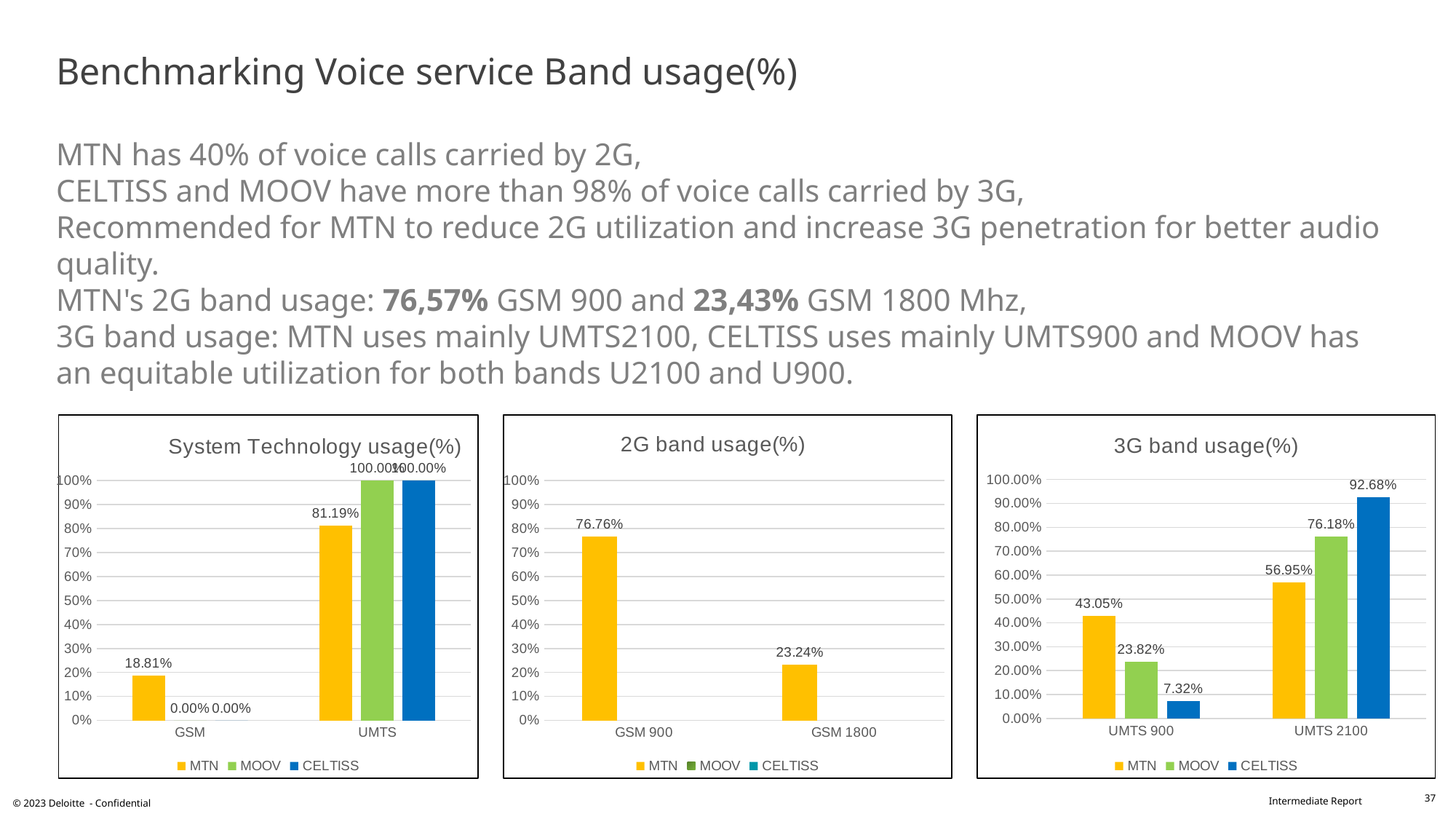
In the "System Technology usage(%)" chart, what is the value for MTN in the UMTS category? 81.19% In the "3G band usage(%)" chart, what is the value for CELTISS at UMTS 2100? 92.68% What kind of chart is the "3G band usage(%)" chart? bar chart In the "2G band usage(%)" chart, what is the difference between MTN's GSM 900 and GSM 1800 values? 53.52% In the "System Technology usage(%)" chart, what is the value for MOOV in the GSM category? 0.00% In the "3G band usage(%)" chart, is the value for MOOV at UMTS 900 larger or smaller than the value for MTN at UMTS 900? smaller In the "System Technology usage(%)" chart, what is the value for MTN in the GSM category? 18.81% In the "3G band usage(%)" chart, which series has the lowest value at UMTS 900? CELTISS In the "2G band usage(%)" chart, how many series does the legend list? 3 In the "3G band usage(%)" chart, what is the difference between MOOV's UMTS 2100 and UMTS 900 values? 52.36% In the "2G band usage(%)" chart, what is the value for MTN at GSM 900? 76.76% In the "3G band usage(%)" chart, which series has the highest value at UMTS 2100? CELTISS